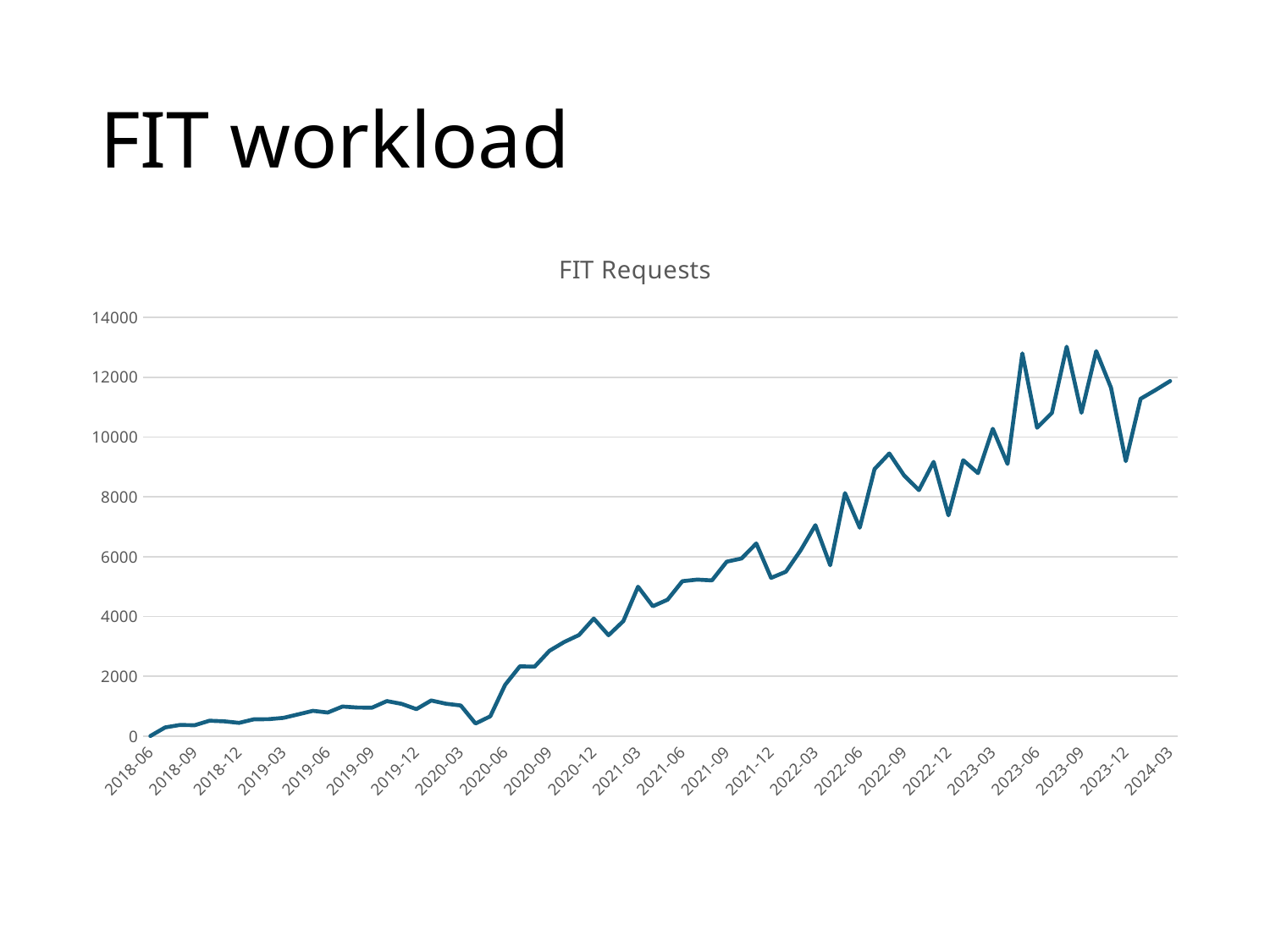
Which labelled month on the x axis has the lowest value? 2018-06 Is the value for 2023-12 greater or less than 10000? less Is the value for 2018-06 greater or less than 2000? less Is the value for 2022-03 greater or less than 6000? greater Do the FIT Requests values generally rise or fall from 2018-06 to 2024-03? rise What is the title of the chart? FIT Requests What kind of chart is shown on the slide? line chart Which has the larger value, 2018-06 or 2024-03? 2024-03 Which has the larger value, 2023-09 or 2023-12? 2023-09